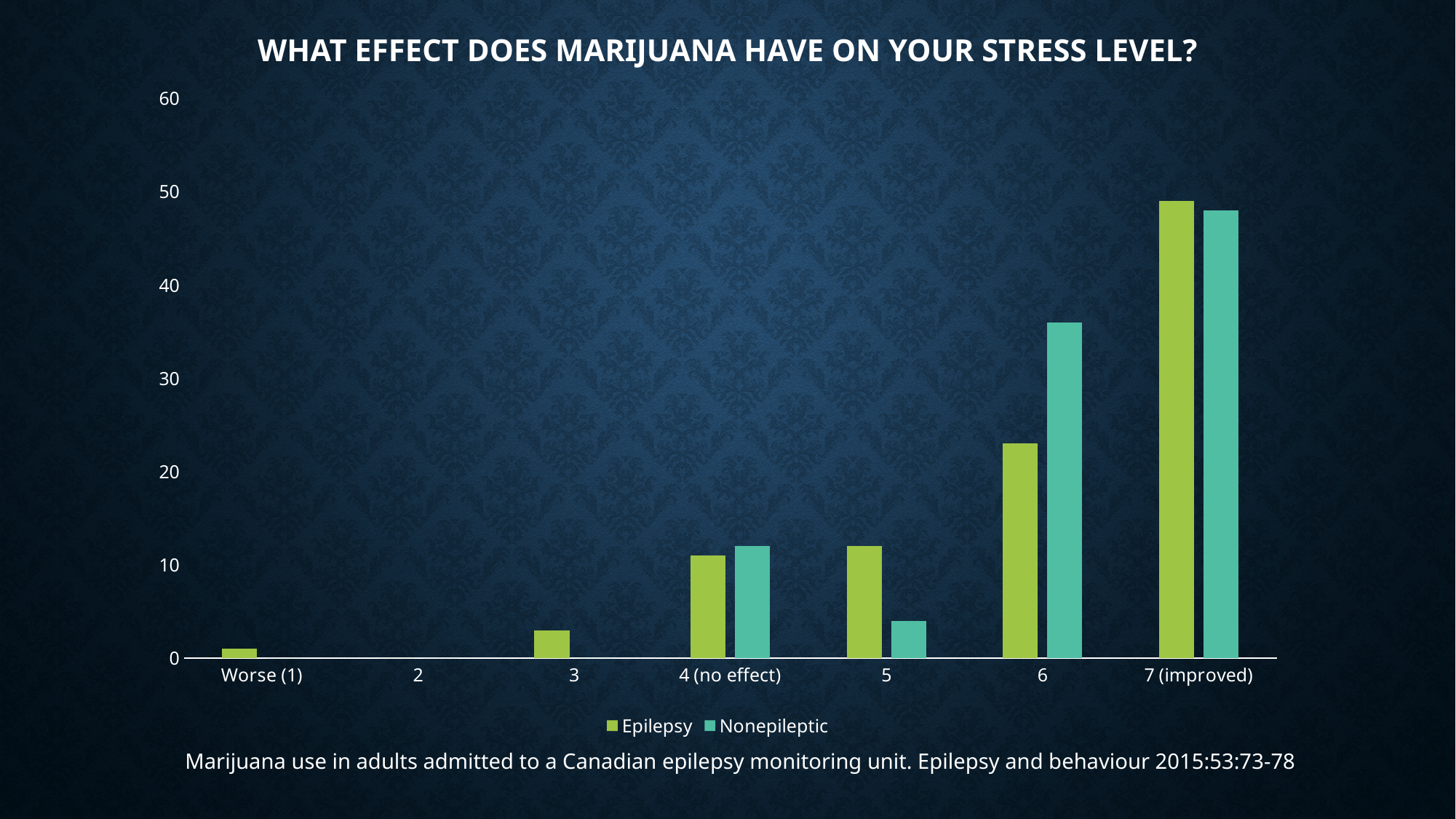
Is the Nonepileptic value for category 5 greater or less than 10? less Which category has the highest value for the Epilepsy series? 7 (improved) What is the title of the chart? What effect does marijuana have on your stress level? What kind of chart is shown on the slide? Bar chart How many series does the legend list? 2 Is the Nonepileptic value for category 6 greater or less than 30? greater Which category has the highest value for the Nonepileptic series? 7 (improved) Do the Epilepsy values generally rise or fall moving from Worse (1) to 7 (improved)? Rise For category 5, which series has the larger value, Epilepsy or Nonepileptic? Epilepsy For category 6, which series has the larger value, Epilepsy or Nonepileptic? Nonepileptic Is the Epilepsy value for category 6 greater or less than 20? greater How many categories are shown along the x axis? 7